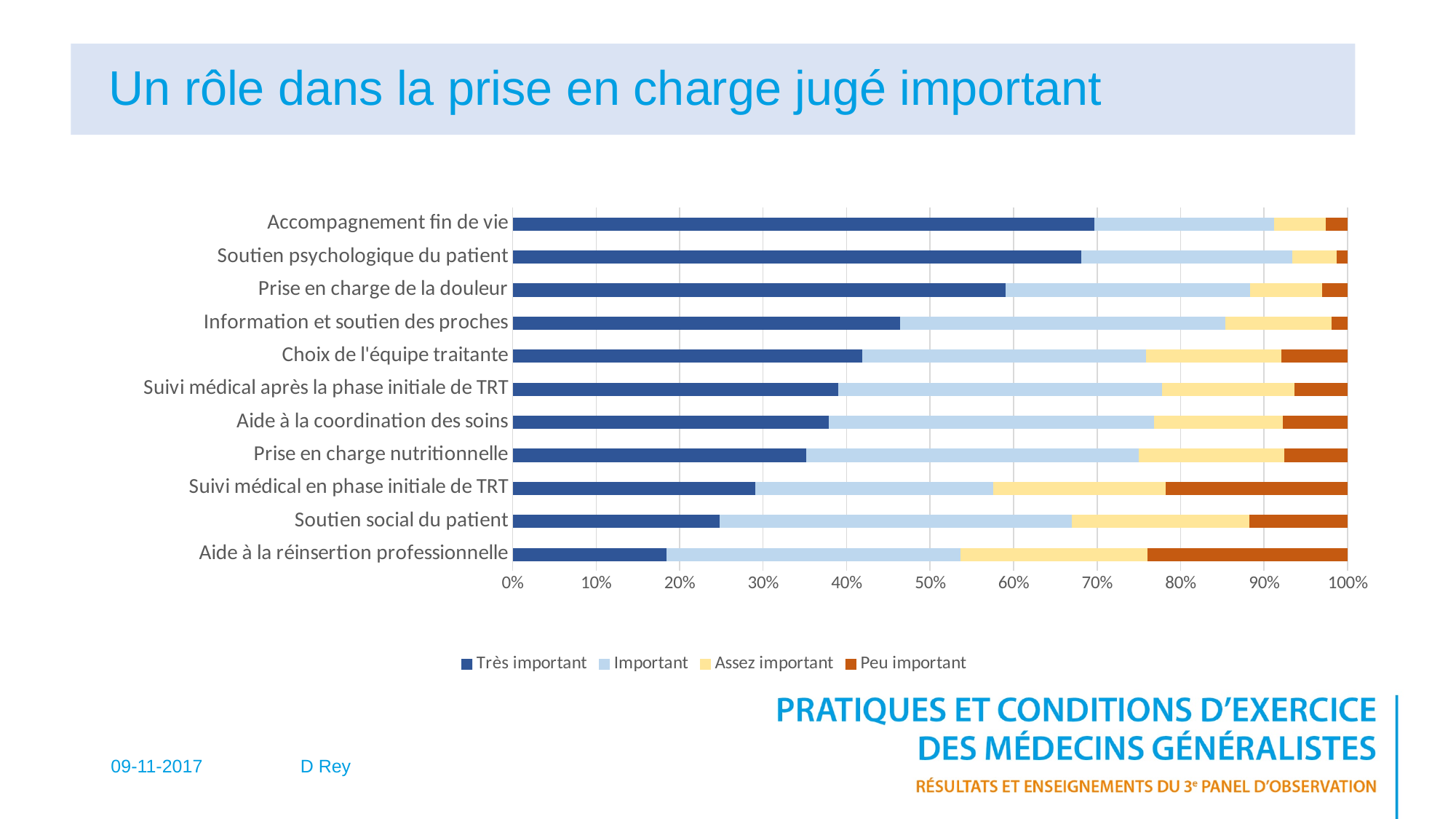
Is the 'Très important' share for Prise en charge de la douleur greater or less than 50%? greater How many series does the legend list? 4 Which has a larger 'Très important' share: Prise en charge de la douleur or Choix de l'équipe traitante? Prise en charge de la douleur What is the title of the slide containing the chart? Un rôle dans la prise en charge jugé important What is the total of the stacked bar for Accompagnement fin de vie? 100% Is the 'Très important' share for Aide à la réinsertion professionnelle greater or less than 30%? less Which category has the lowest share of 'Très important'? Aide à la réinsertion professionnelle Which has a larger 'Très important' share: Soutien social du patient or Aide à la réinsertion professionnelle? Soutien social du patient How many categories (roles) are listed on the chart? 11 Is the 'Très important' share for Accompagnement fin de vie greater or less than 60%? greater What kind of chart is shown on the slide? Stacked bar chart